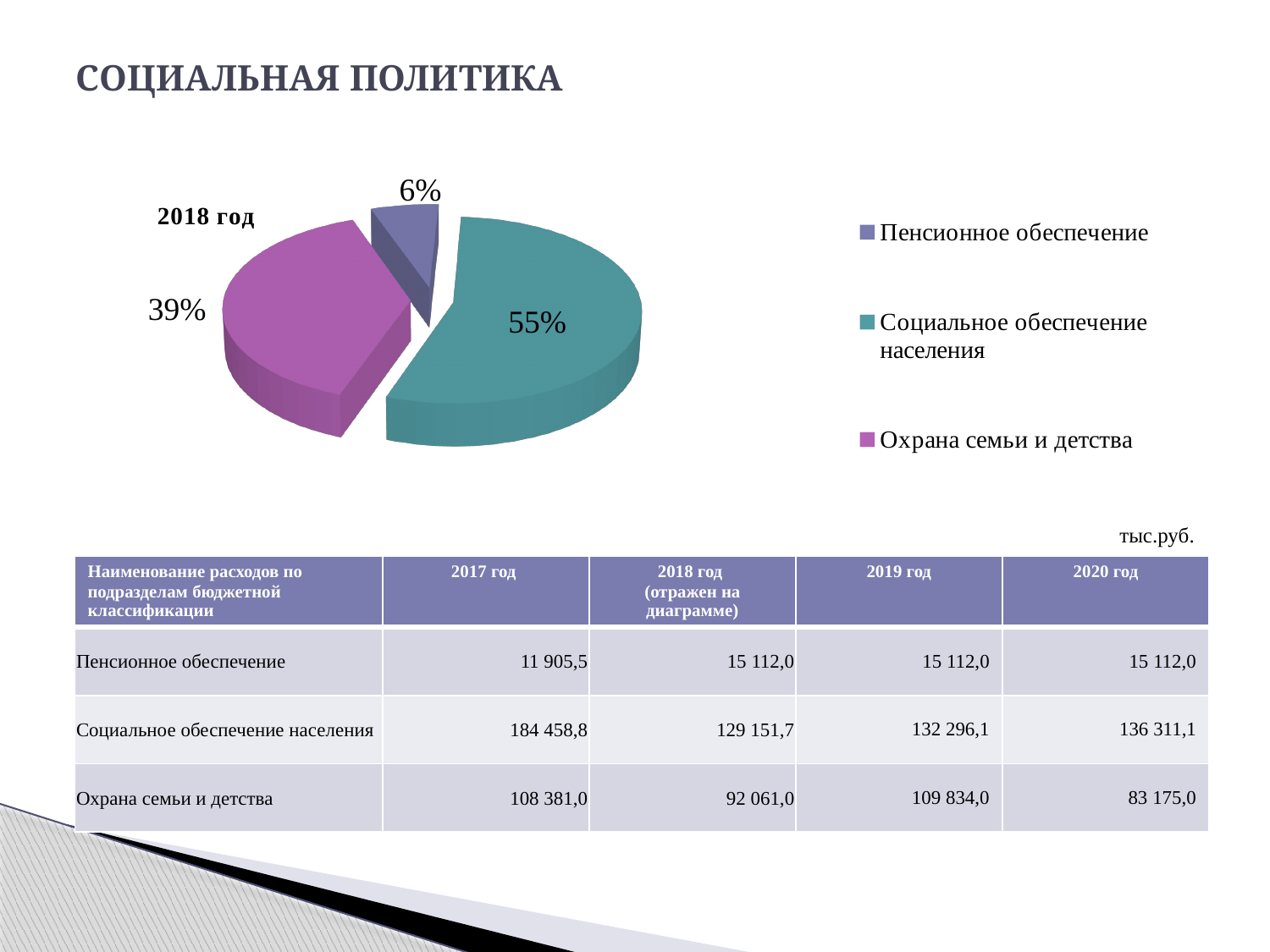
What kind of chart is shown on the slide? Pie chart Which year is the pie chart labelled with? 2018 год How many slices does the pie chart have? 3 Which category has the largest slice of the pie? Социальное обеспечение населения By how many percentage points does the share of Социальное обеспечение населения exceed the share of Охрана семьи и детства? 16 How many entries does the legend of the pie chart list? 3 Which category has the smallest slice of the pie? Пенсионное обеспечение What colour is the slice for Охрана семьи и детства in the pie chart? Magenta (purple-pink) Which slice is larger: Охрана семьи и детства or Пенсионное обеспечение? Охрана семьи и детства What share of the pie does Социальное обеспечение населения have? 55% What share of the pie does Охрана семьи и детства have? 39% What share of the pie does Пенсионное обеспечение have? 6%